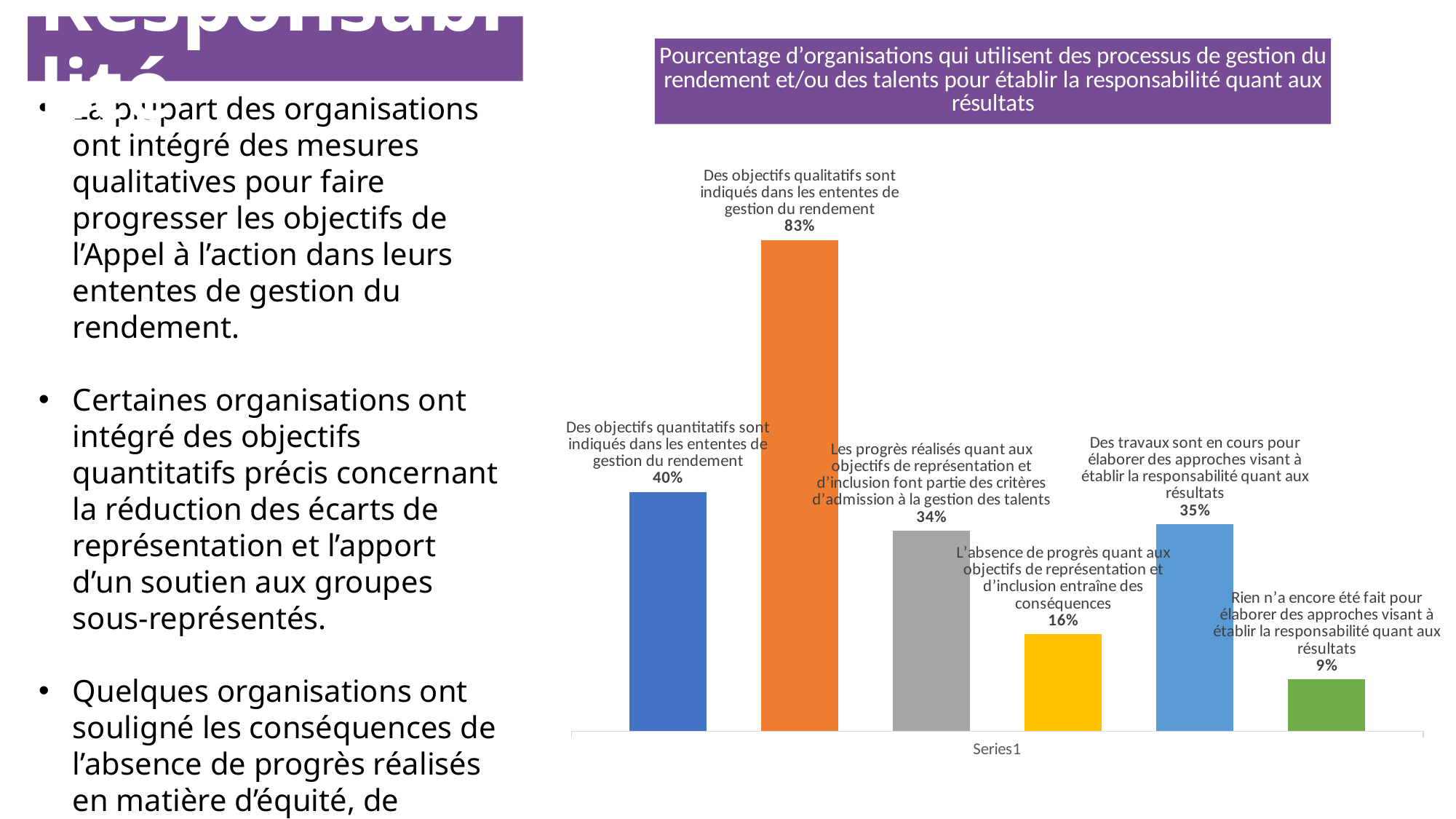
What is the value for "Rien n'a encore été fait pour élaborer des approches visant à établir la responsabilité quant aux résultats"? 9% What percentage of organisations have qualitative objectives indicated in their performance management agreements ("Des objectifs qualitatifs sont indiqués dans les ententes de gestion du rendement")? 83% How many bars are plotted in the chart? 6 What type of chart is shown on the slide? Bar chart What colour is the bar for "Des objectifs qualitatifs sont indiqués dans les ententes de gestion du rendement"? Orange What is the value for "Des objectifs quantitatifs sont indiqués dans les ententes de gestion du rendement"? 40% What is the difference between the value for "Des travaux sont en cours..." (35%) and "Rien n'a encore été fait..." (9%)? 26% What is the difference between the value for qualitative objectives (83%) and the value for quantitative objectives (40%)? 43% Which is larger: the value for "Des travaux sont en cours pour élaborer des approches visant à établir la responsabilité quant aux résultats" or the value for "Les progrès réalisés quant aux objectifs de représentation et d'inclusion font partie des critères d'admission à la gestion des talents"? Des travaux sont en cours pour élaborer des approches visant à établir la responsabilité quant aux résultats What is the value for "L'absence de progrès quant aux objectifs de représentation et d'inclusion entraîne des conséquences"? 16% Which category has the lowest value in the chart? Rien n'a encore été fait pour élaborer des approches visant à établir la responsabilité quant aux résultats Which category has the highest value in the chart? Des objectifs qualitatifs sont indiqués dans les ententes de gestion du rendement